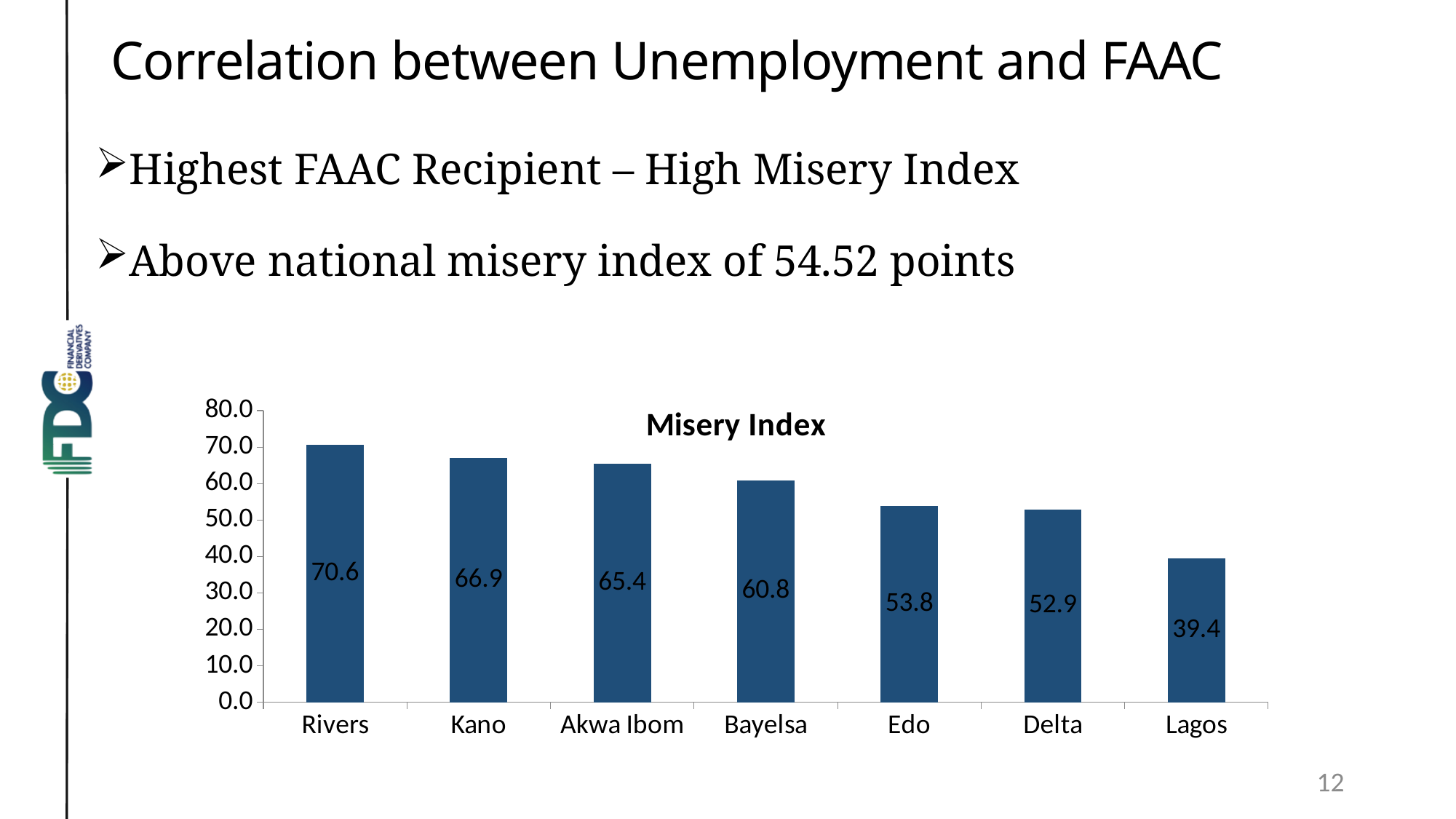
What is the Misery Index value for Rivers? 70.6 What kind of chart is used to show the Misery Index? Bar chart What is the difference between the Misery Index values for Kano and Akwa Ibom? 1.5 What is the difference between the Misery Index values for Rivers and Lagos? 31.2 Which state has the highest Misery Index? Rivers How many states are shown in the Misery Index chart? 7 What is the Misery Index value for Lagos? 39.4 Is the Misery Index value for Delta greater or less than 50.0? greater Do the Misery Index values rise or fall from left to right across the states? Fall Which state has the lowest Misery Index? Lagos What is the Misery Index value for Bayelsa? 60.8 Which has a higher Misery Index, Edo or Bayelsa? Bayelsa